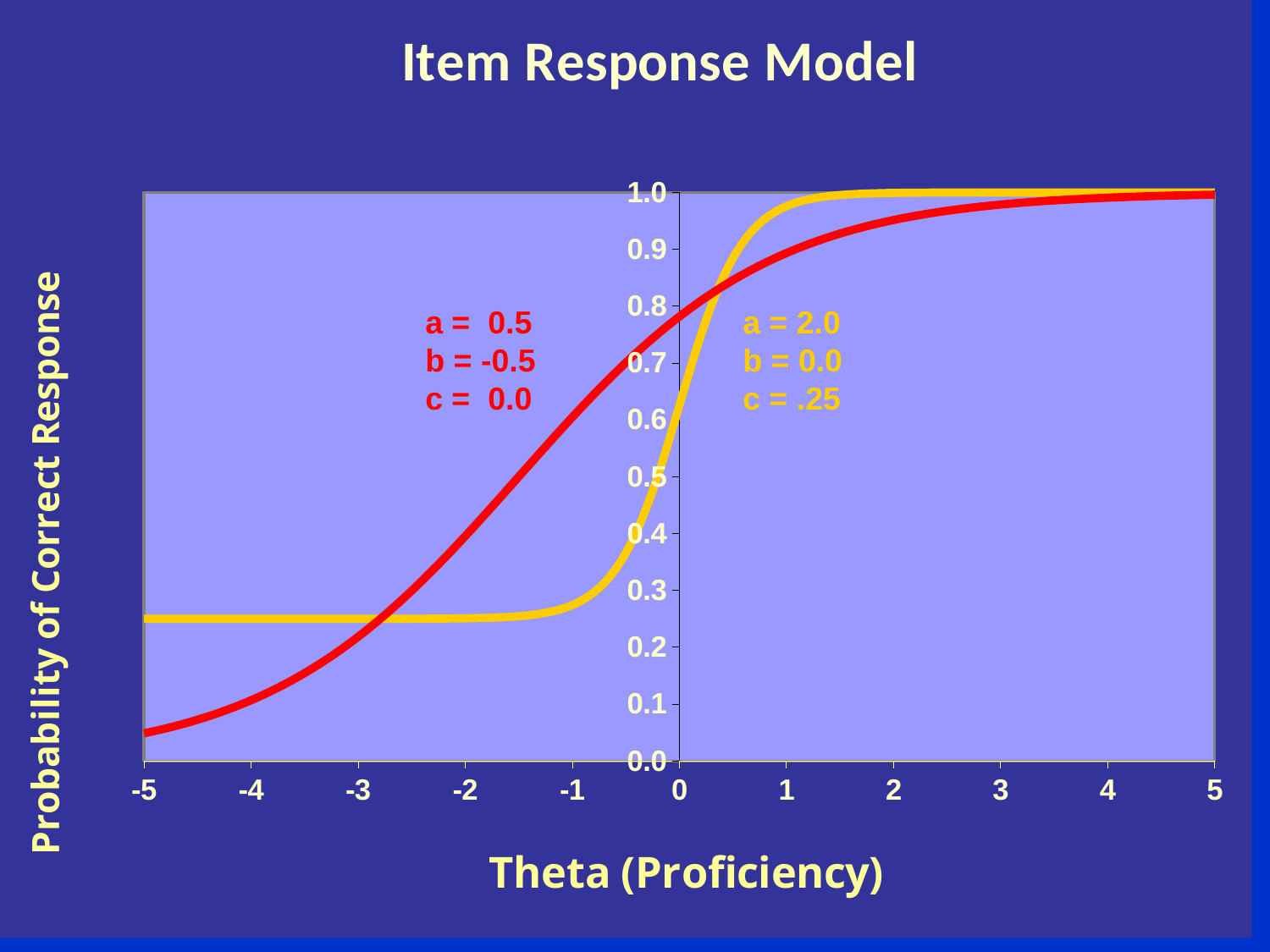
Is the value of the yellow curve at Theta = -3 greater or less than 0.2? greater What is the label of the x axis? Theta (Proficiency) What is the title of the chart? Item Response Model What is the value of parameter c for the yellow curve? .25 Is the value of the red curve at Theta = -5 greater or less than 0.1? less What is the value of parameter a for the red curve? 0.5 At Theta = -1, which curve has the higher probability of correct response, the red or the yellow? red How many curves are plotted on the chart? 2 Do the curves rise or fall as Theta increases from -5 to 5? rise What is the value of parameter b for the red curve? -0.5 What kind of chart is shown on the slide? line chart At Theta = 1, which curve has the higher probability of correct response, the red or the yellow? yellow